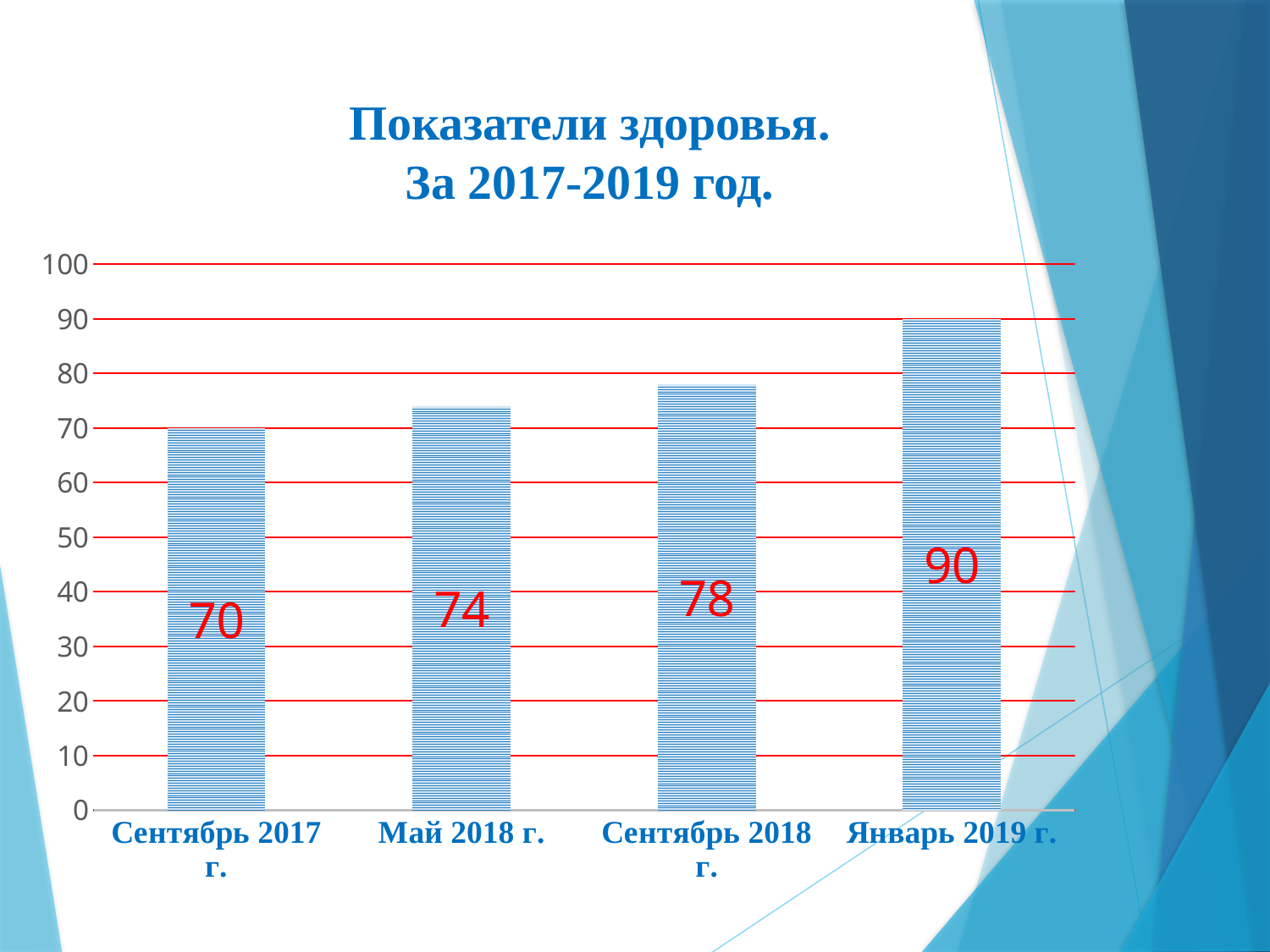
How many categories are shown on the x axis? 4 What is the difference between the values for Январь 2019 г. and Сентябрь 2017 г.? 20 What kind of chart is shown on the slide? bar chart Which is larger, the value for Май 2018 г. or the value for Сентябрь 2018 г.? Сентябрь 2018 г. What is the value for Сентябрь 2018 г.? 78 Which category has the lowest value? Сентябрь 2017 г. Do the values rise or fall from Сентябрь 2017 г. to Январь 2019 г.? rise What is the difference between the values for Сентябрь 2018 г. and Май 2018 г.? 4 What is the value for Январь 2019 г.? 90 Which category has the highest value? Январь 2019 г. What is the value for Сентябрь 2017 г.? 70 What is the value for Май 2018 г.? 74